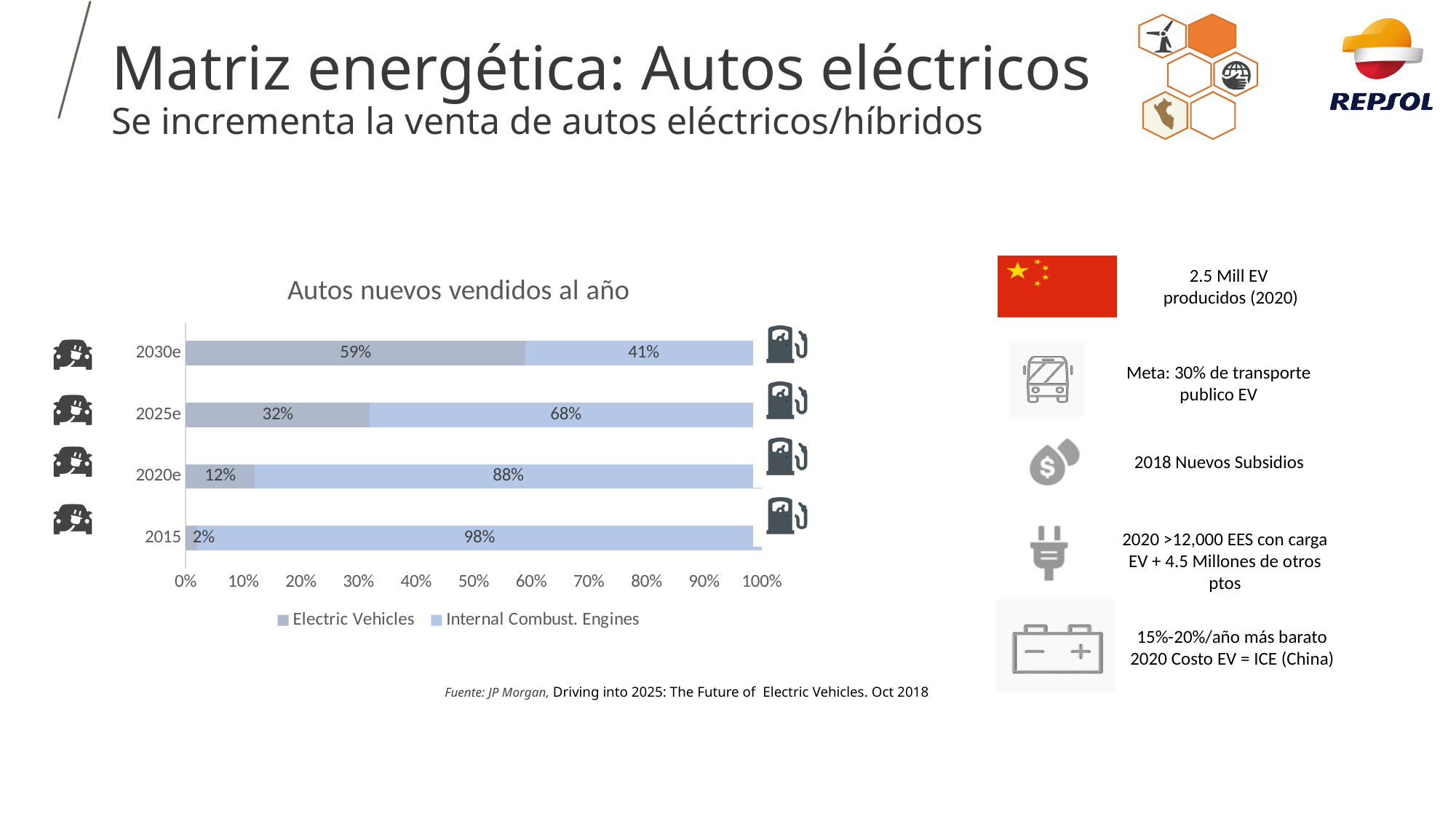
Which is larger for 2025e: Electric Vehicles or Internal Combust. Engines? Internal Combust. Engines What is the Electric Vehicles share for 2030e? 59% How many years are shown on the chart? 4 What kind of chart is shown? Stacked bar chart Which year has the highest Electric Vehicles share? 2030e How many series does the legend list? 2 What is the difference between the Electric Vehicles shares for 2030e and 2025e? 27% What is the Internal Combust. Engines share for 2020e? 88% Which year has the lowest Internal Combust. Engines share? 2030e What is the Electric Vehicles share for 2015? 2% What is the title of the chart? Autos nuevos vendidos al año What is the total of the stacked bar for 2020e? 100%